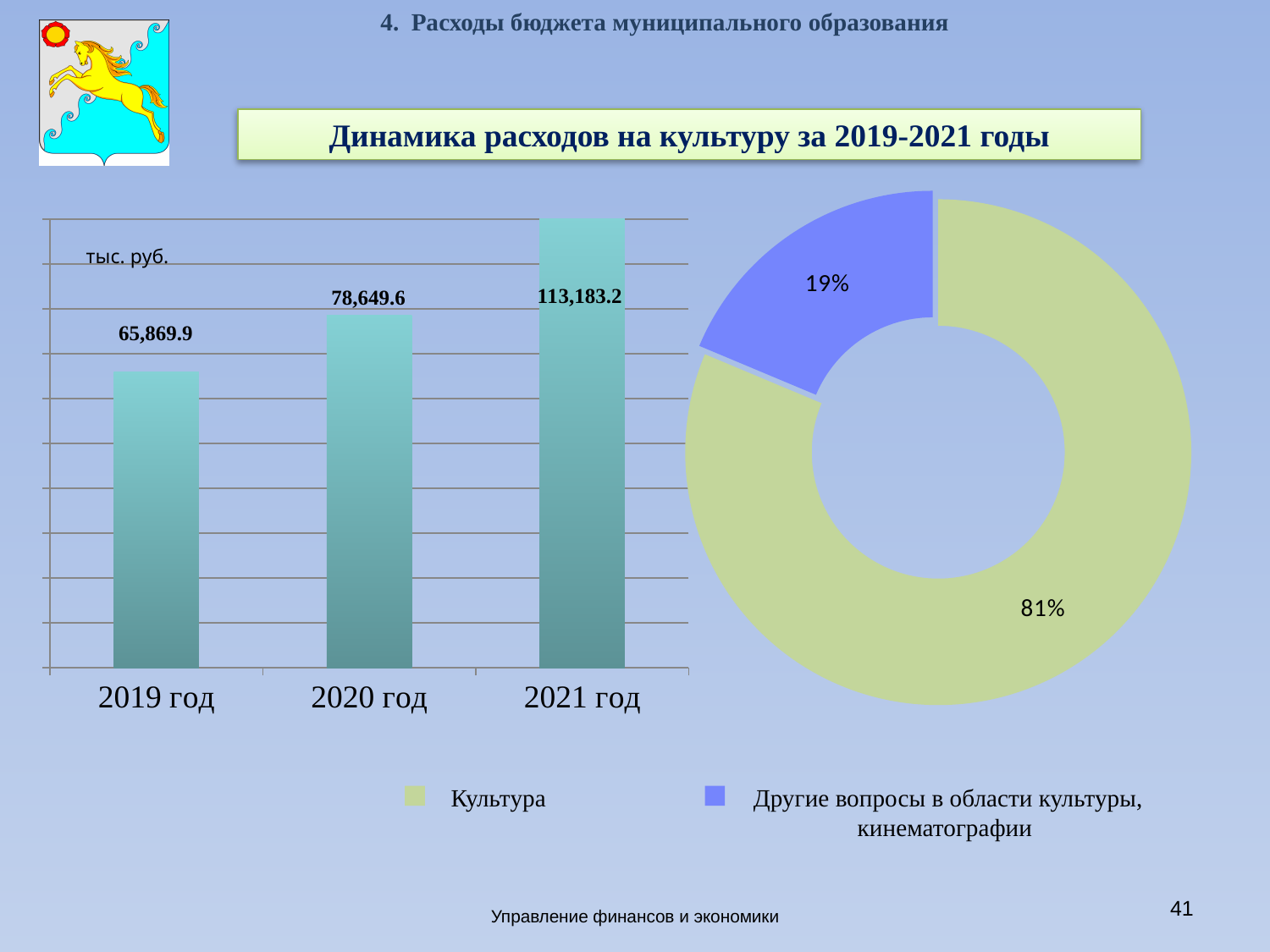
What kind of chart is on the left side of the slide? bar chart How many bars are in the bar chart on the left? 3 In the bar chart on the left, what is the value for 2019 год? 65,869.9 In the bar chart on the left, what is the difference between the values for 2021 год and 2020 год? 34,533.6 In the bar chart on the left, do the values rise or fall from 2019 год to 2021 год? rise In the bar chart on the left, what is the difference between the values for 2020 год and 2019 год? 12,779.7 In the bar chart on the left, which year has the highest value? 2021 год In the doughnut chart on the right, which is larger: Культура or Другие вопросы в области культуры, кинематографии? Культура In the doughnut chart on the right, what share does Культура have? 81% In the bar chart on the left, what is the value for 2020 год? 78,649.6 In the bar chart on the left, which year has the lowest value? 2019 год In the bar chart on the left, what is the value for 2021 год? 113,183.2